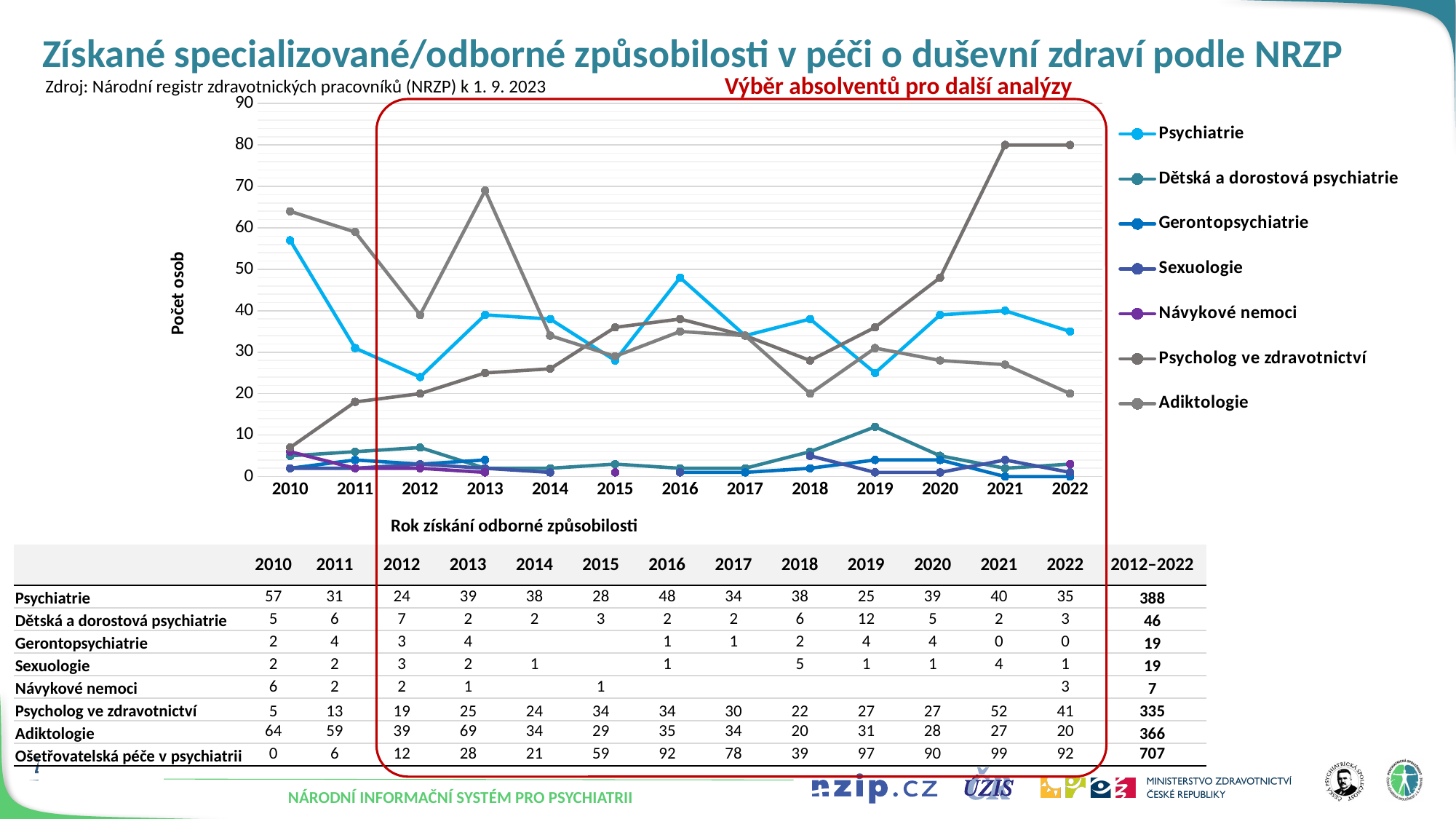
What is the value for Psychiatrie in 2010? 57 Is the value for Adiktologie in 2011 greater or less than 50? greater What is the value for Adiktologie in 2013? 69 What is the value for Dětská a dorostová psychiatrie in 2019? 12 Which is larger in 2010, the value for Adiktologie or the value for Psychiatrie? Adiktologie What is the label of the y axis of the chart? Počet osob How many years are shown along the x axis of the chart? 13 In which year is the value for Psychiatrie highest? 2010 In which year is the value for Psychiatrie lowest? 2012 How many series does the chart legend list? 7 What kind of chart is shown on the slide? line chart What is the difference between the Psychiatrie values for 2016 and 2015? 20